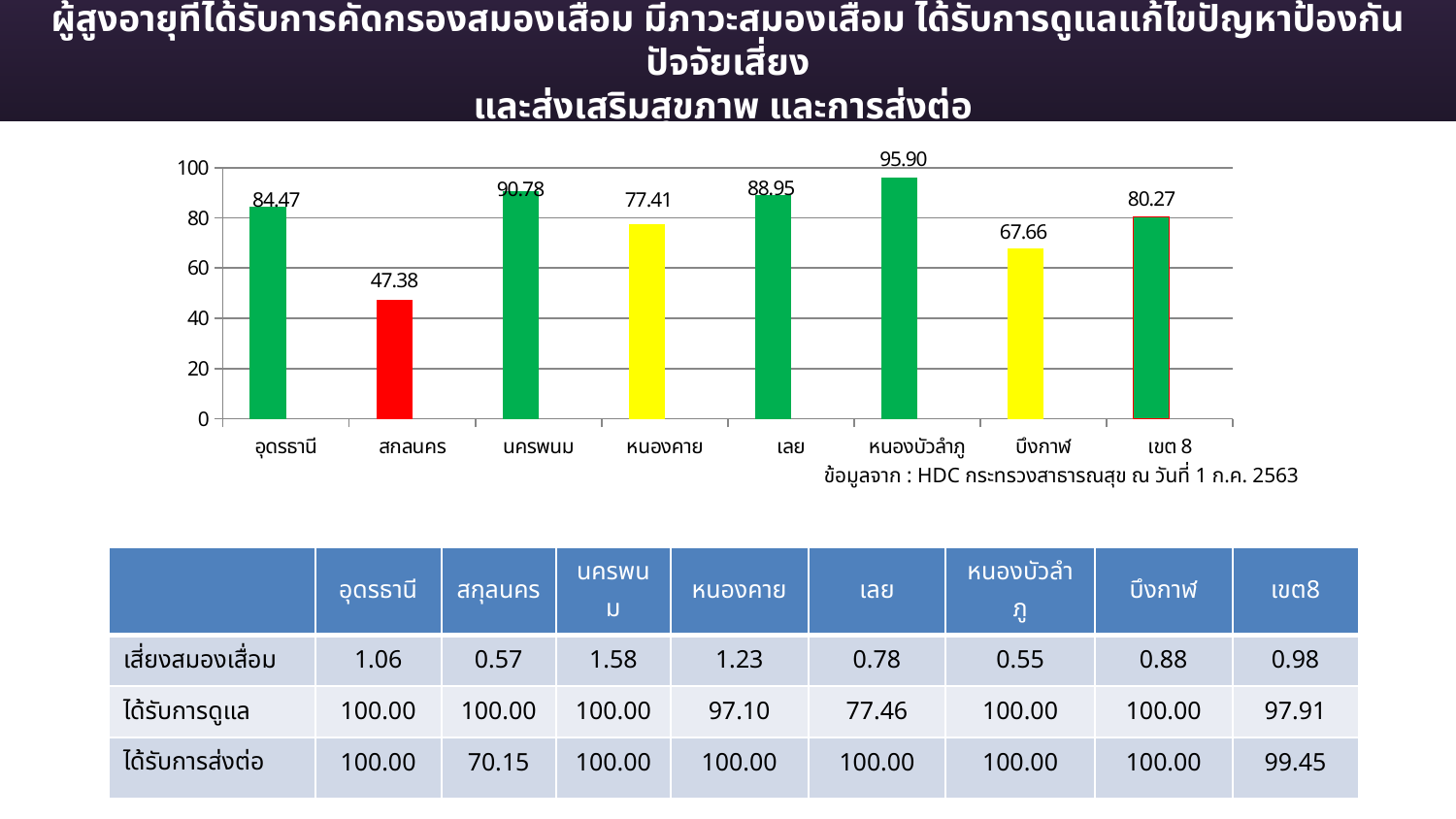
Which category has the highest value in the bar chart? หนองบัวลำภู What is the value for บึงกาฬ in the bar chart? 67.66 What colour is the bar for สกลนคร? red What is the value for อุดรธานี in the bar chart? 84.47 How many categories are shown on the x axis of the bar chart? 8 Which category has the lowest value in the bar chart? สกลนคร Is the value for หนองคาย greater or less than 80? less Which is larger, the value for นครพนม or the value for เลย? นครพนม What is the value for เขต 8 in the bar chart? 80.27 What kind of chart is shown on the slide? bar chart What is the value for สกลนคร in the bar chart? 47.38 What is the difference between the values for หนองบัวลำภู and สกลนคร? 48.52